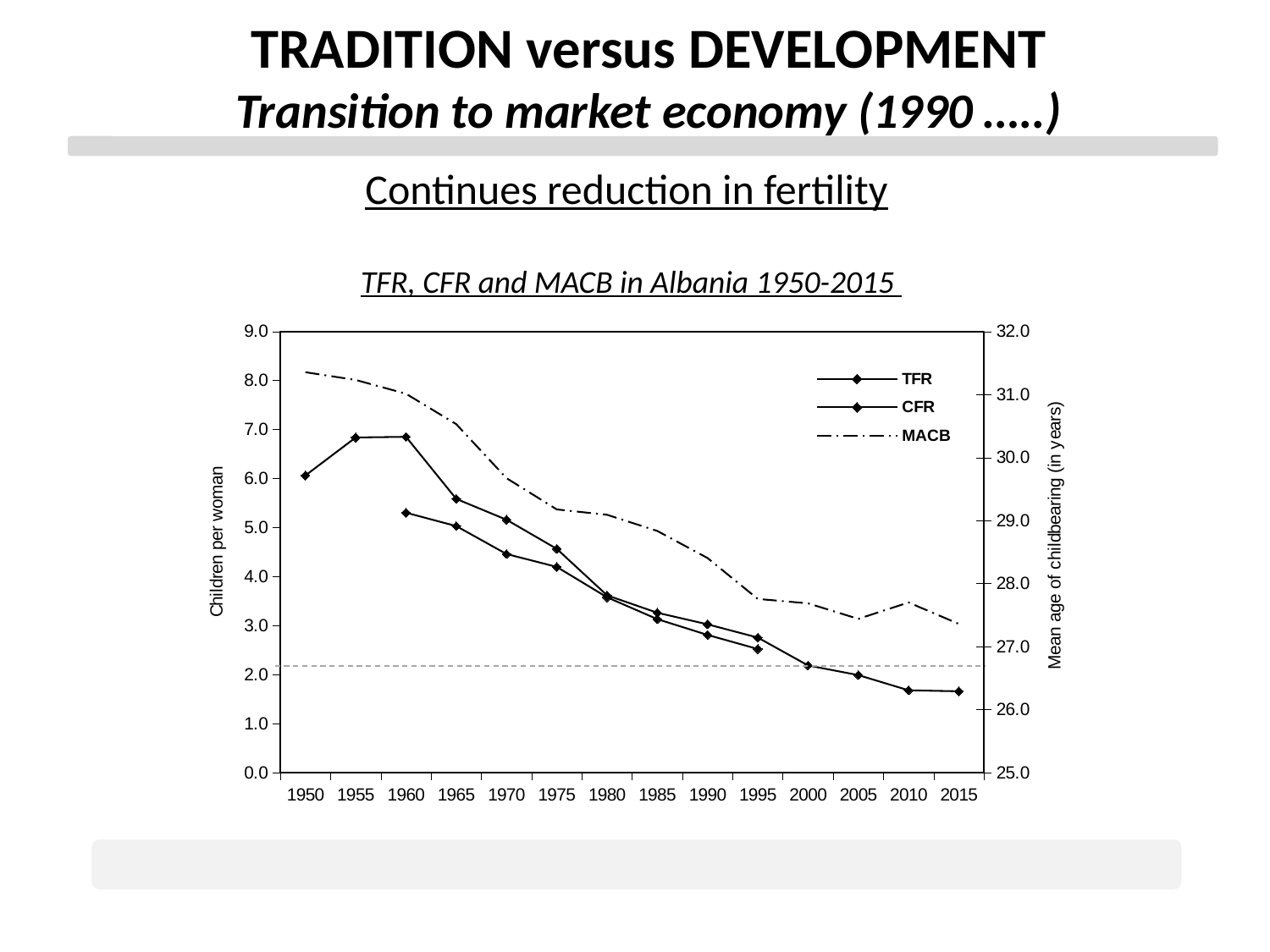
Is the MACB value for 1950 greater or less than 31.0? greater Is the MACB value higher in 1950 or in 2015? 1950 What kind of chart is shown on the slide? line chart Which series are listed in the chart legend? TFR, CFR, MACB Is the MACB value for 1975 greater or less than 29.0? greater Is the children-per-woman value plotted for 2015 greater or less than 2.0? less How many years are labelled on the x axis of the chart? 14 In which year is the MACB series at its highest? 1950 Does the MACB series rise or fall overall from 1950 to 2015? fall How many series does the chart legend list? 3 What is the title of the chart? TFR, CFR and MACB in Albania 1950-2015